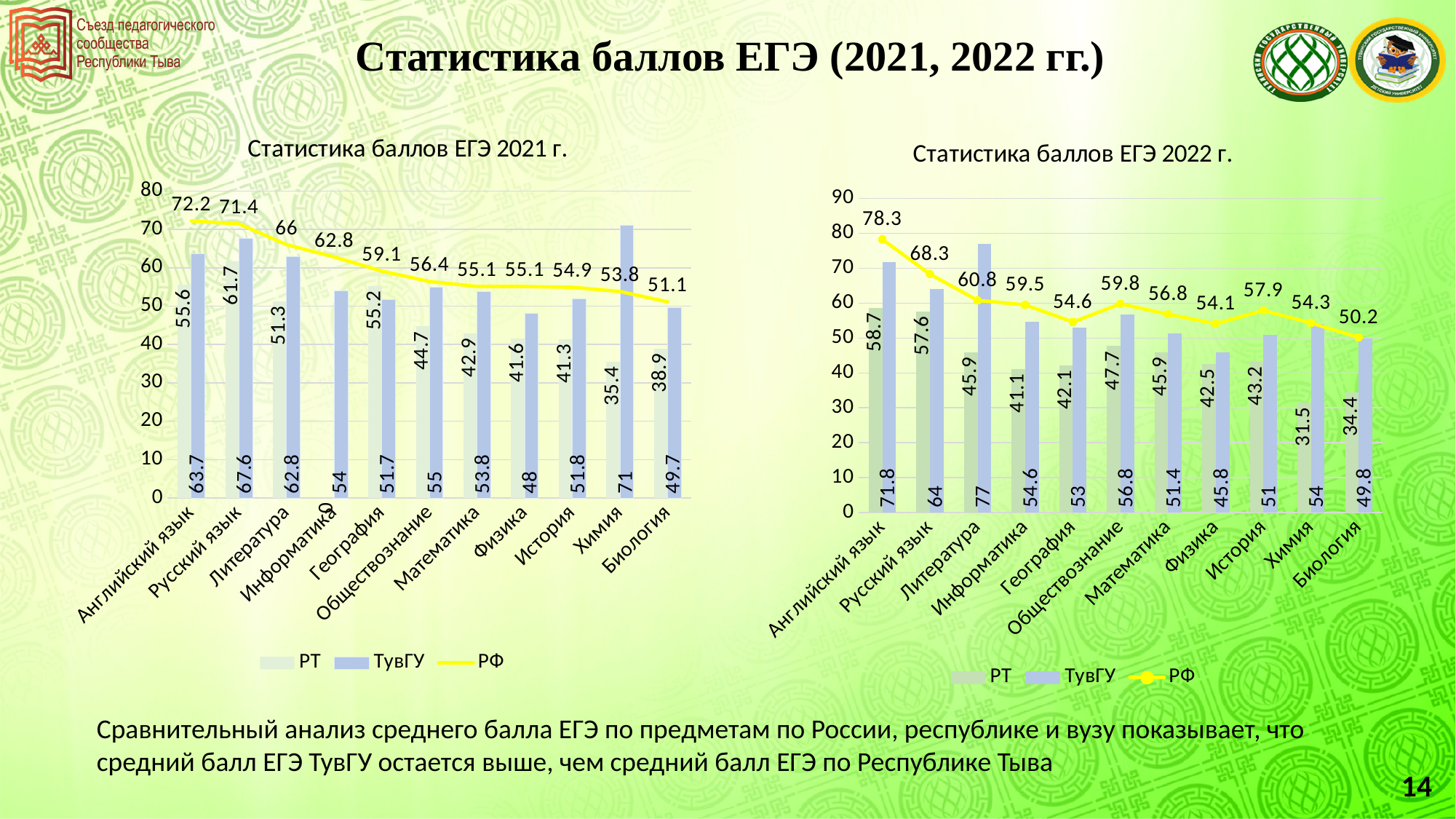
In the chart 'Статистика баллов ЕГЭ 2022 г.', which category has the highest РФ value? Английский язык In the chart 'Статистика баллов ЕГЭ 2022 г.', which is larger for Физика: the РТ value or the ТувГУ value? ТувГУ In the chart 'Статистика баллов ЕГЭ 2022 г.', what is the РТ value for Химия? 31.5 In the chart 'Статистика баллов ЕГЭ 2021 г.', which category has the highest ТувГУ value? Химия In the chart 'Статистика баллов ЕГЭ 2021 г.', which category has the lowest РТ value? Информатика In the chart 'Статистика баллов ЕГЭ 2021 г.', what is the РФ value for Английский язык? 72.2 In the chart 'Статистика баллов ЕГЭ 2022 г.', what is the ТувГУ value for Литература? 77 In the chart 'Статистика баллов ЕГЭ 2021 г.', does the РФ line rise or fall from Английский язык to Биология? fall In the chart 'Статистика баллов ЕГЭ 2021 г.', what is the difference between the ТувГУ and РТ values for Русский язык? 5.9 How many series does the legend of the chart 'Статистика баллов ЕГЭ 2021 г.' list? 3 In the chart 'Статистика баллов ЕГЭ 2021 г.', what is the ТувГУ value for Химия? 71 How many categories are shown on the x axis of the chart 'Статистика баллов ЕГЭ 2022 г.'? 11